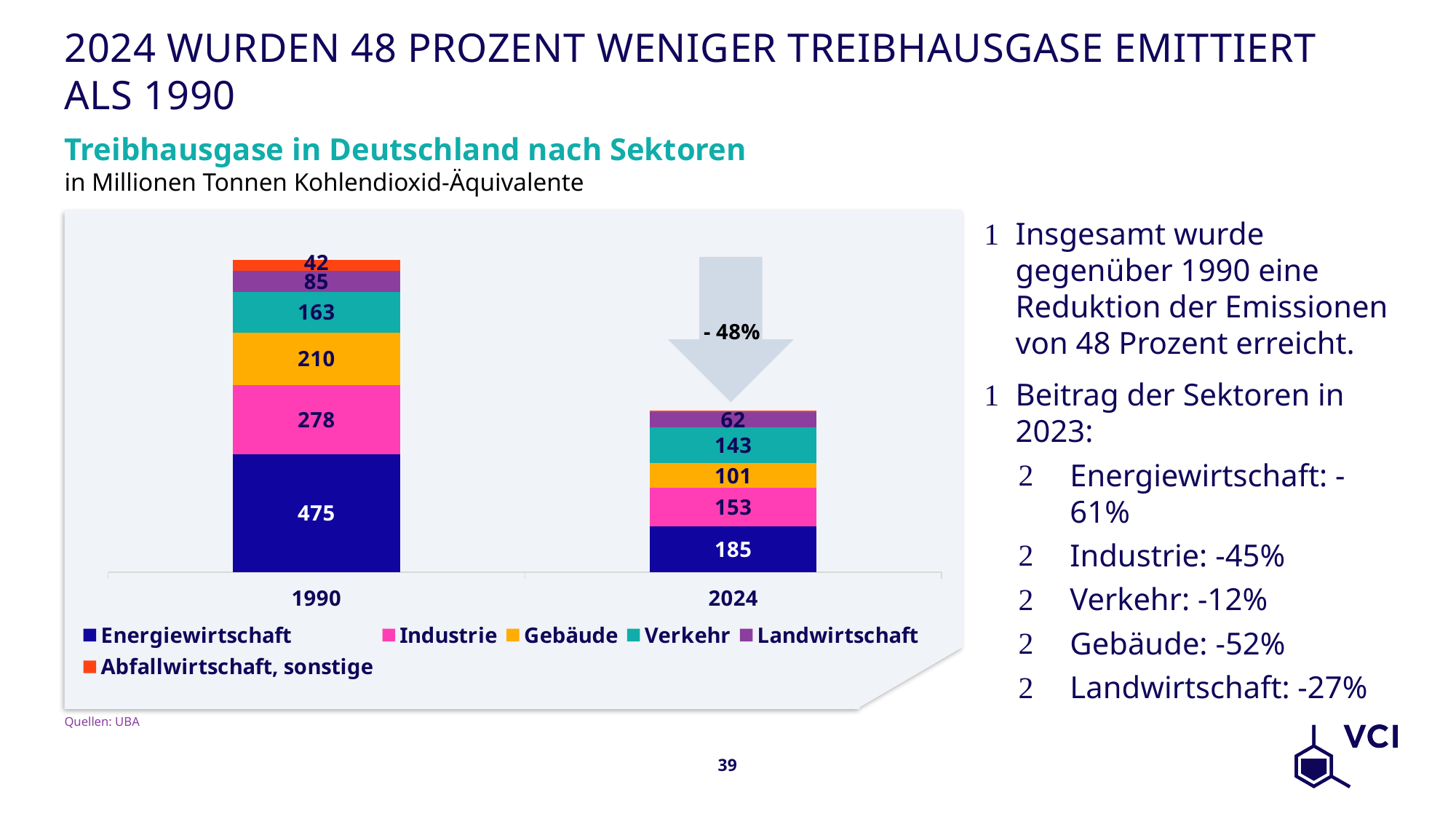
What is the value for Verkehr in 2024? 143 What is the value for Energiewirtschaft in 1990? 475 Which labelled sector has the smallest value in the 1990 bar? Abfallwirtschaft, sonstige What is the difference between the Energiewirtschaft values for 1990 and 2024? 290 What is the value for Gebäude in 2024? 101 What is the total of the 1990 stacked bar? 1253 What kind of chart is shown on the slide? Stacked bar chart What is the value for Landwirtschaft in 1990? 85 Which sector has the largest value in the 1990 bar? Energiewirtschaft How many series does the legend list? 6 Which is larger in 2024, Verkehr or Gebäude? Verkehr What is the value for Industrie in 2024? 153